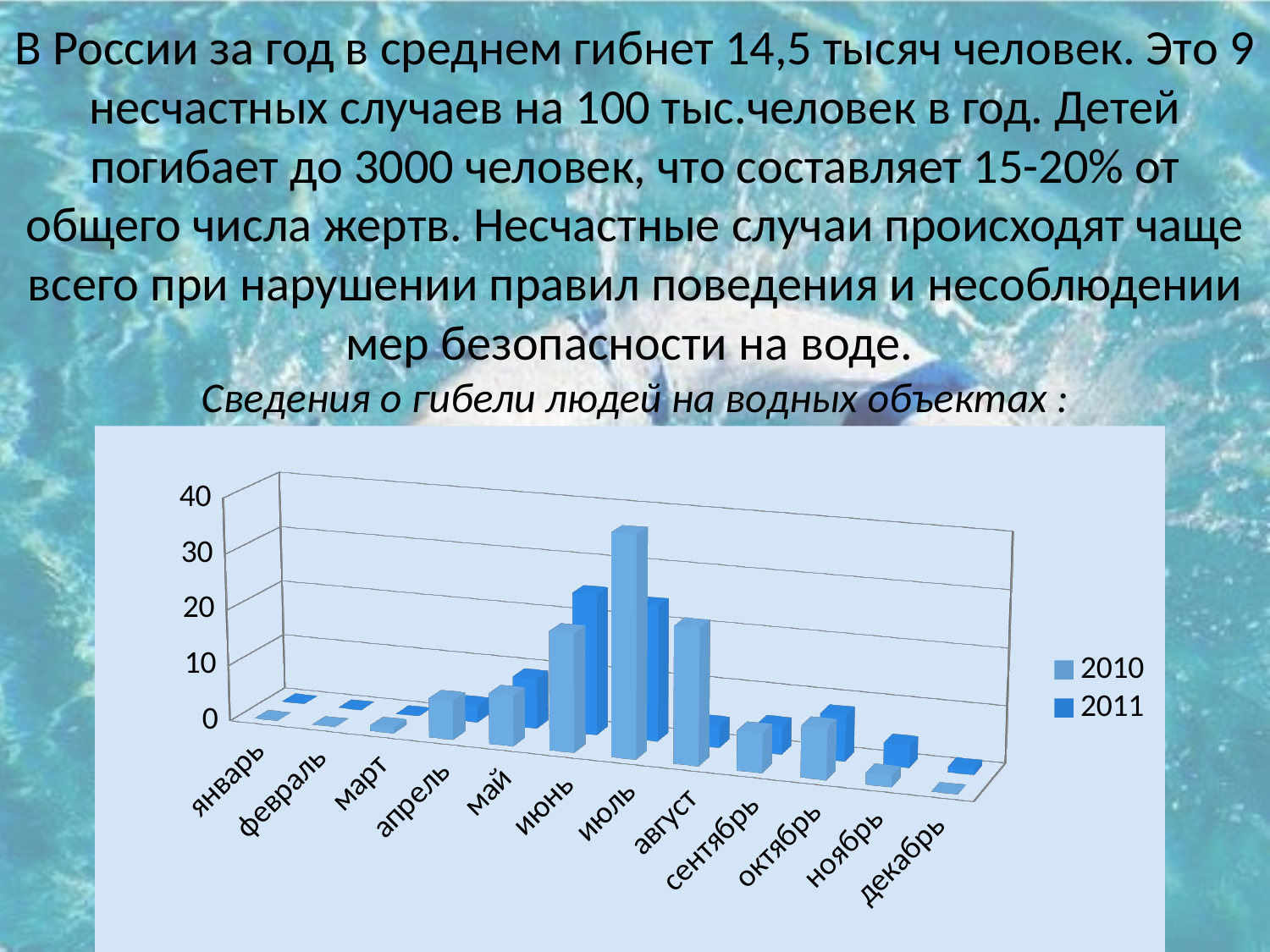
Is the value for январь in the 2010 series greater or less than 10? less Which series is shown in the darker blue colour in the legend? 2011 For июнь, which series has the larger value, 2010 or 2011? 2011 For июль, which series has the larger value, 2010 or 2011? 2010 What kind of chart is shown on the slide? bar chart What is the title of the chart? Сведения о гибели людей на водных объектах Is the value for август in the 2010 series greater or less than 10? greater Is the value for июль in the 2010 series greater or less than 20? greater Do the values for the 2010 series rise or fall from июль to декабрь? fall How many categories (months) are shown on the x axis of the chart? 12 How many series does the chart legend list? 2 Which month has the highest value for the 2010 series? июль